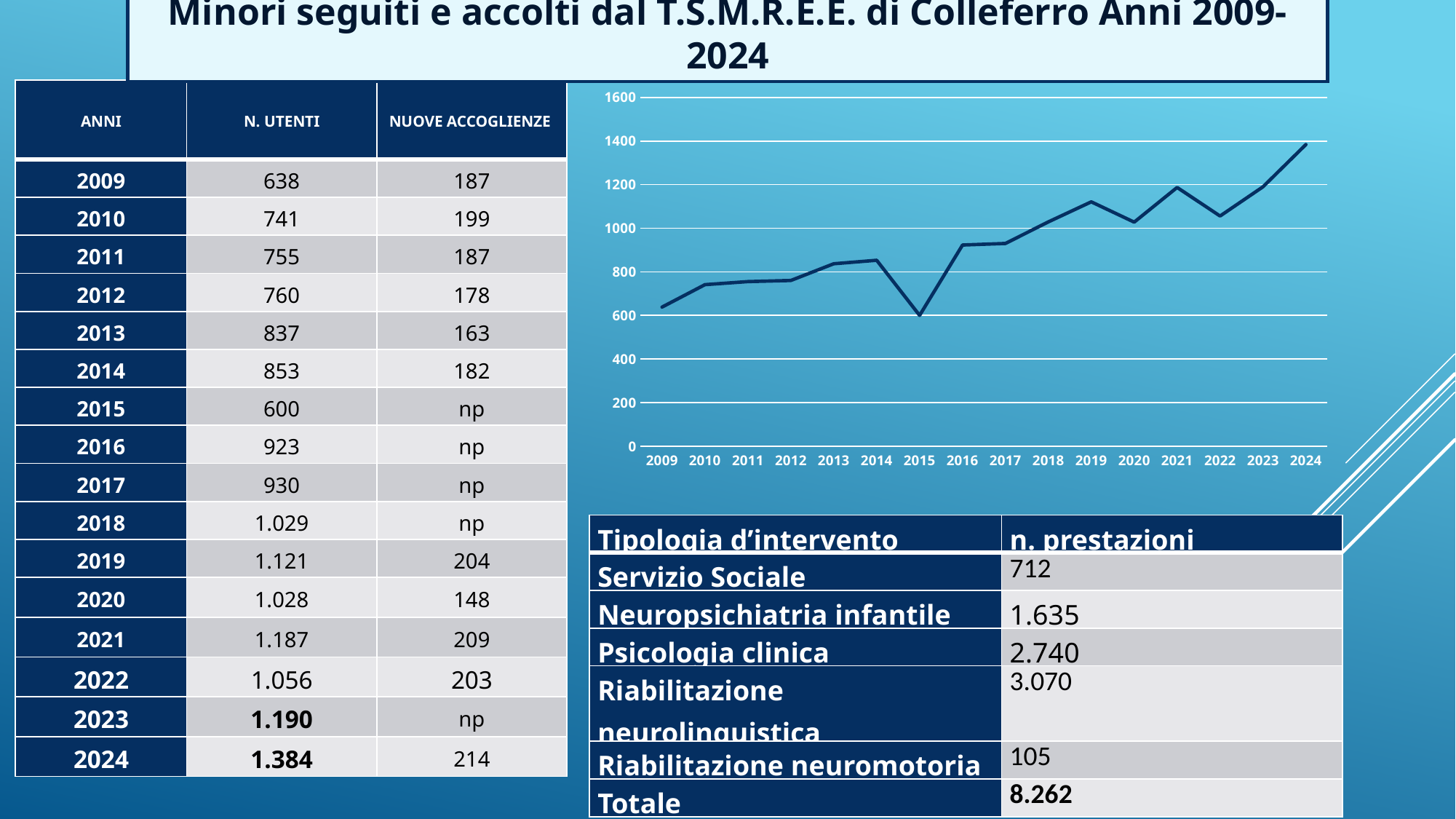
On the line chart, is the value for 2009 greater or less than 800? less Does the line rise or fall from 2009 to 2014? rise Which year has the highest value on the line chart? 2024 On the line chart, is the value for 2021 greater or less than 1000? greater According to the table, what is the N. UTENTI value for 2024, the last point on the line chart? 1.384 On the line chart, is the value for 2015 greater or less than 800? less Which year has the lowest value on the line chart? 2015 How many years are plotted along the x axis of the line chart? 16 What kind of chart is shown on the slide? line chart What is the highest tick value shown on the y axis of the line chart? 1600 Does the line rise or fall from 2014 to 2015? fall